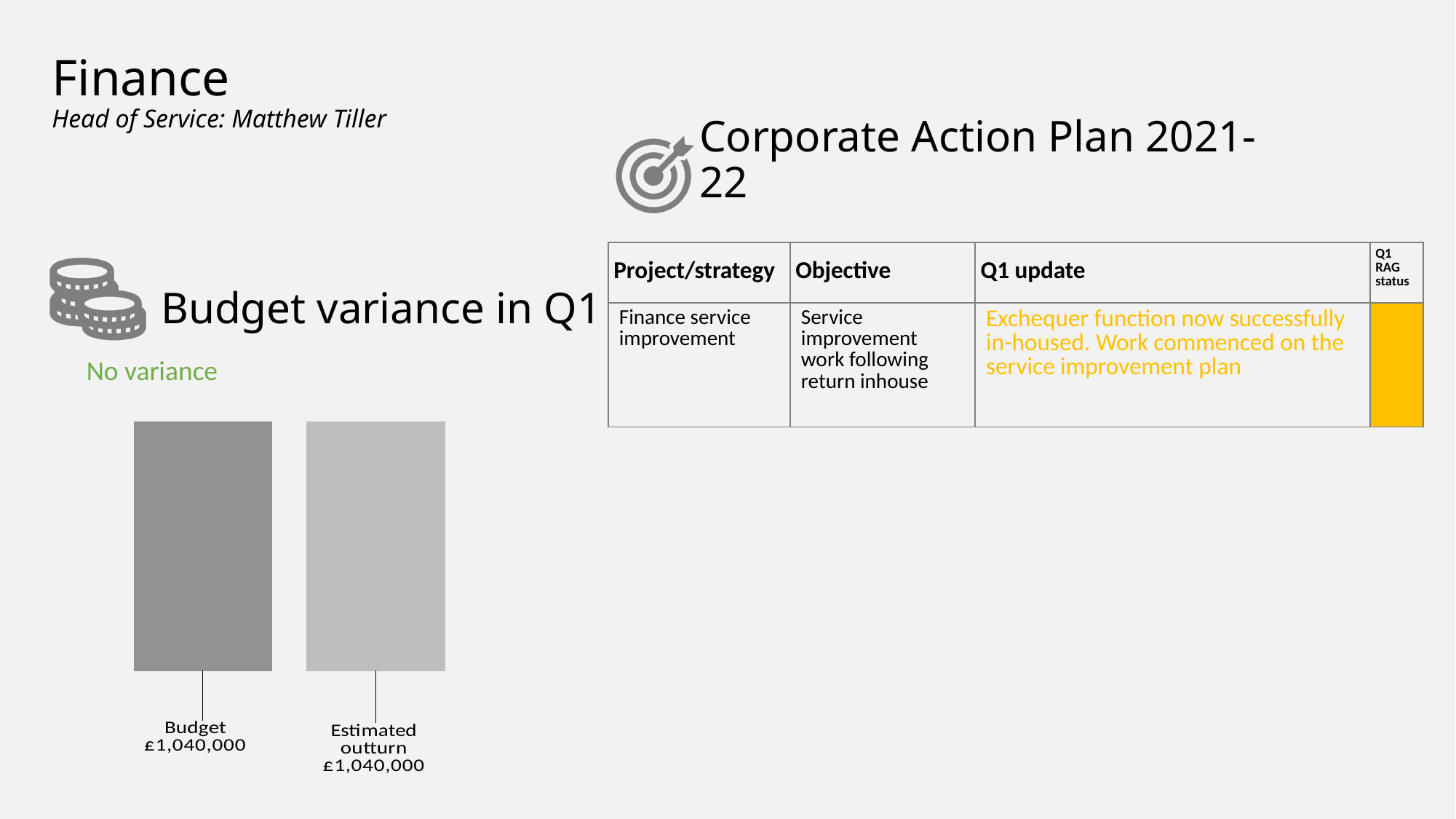
Is the Estimated outturn value in the Budget variance in Q1 chart greater than, less than, or equal to the Budget value? Equal What is the value of the Budget bar in the Budget variance in Q1 chart? £1,040,000 What is the value of the Estimated outturn bar in the Budget variance in Q1 chart? £1,040,000 How many bars are plotted in the Budget variance in Q1 chart? 2 What is the title of the chart on the left of the slide? Budget variance in Q1 What is the difference between the Budget and the Estimated outturn values in the Budget variance in Q1 chart? £0 What are the two categories shown on the x axis of the Budget variance in Q1 chart? Budget and Estimated outturn What kind of chart is used to show the budget variance in Q1? Bar chart